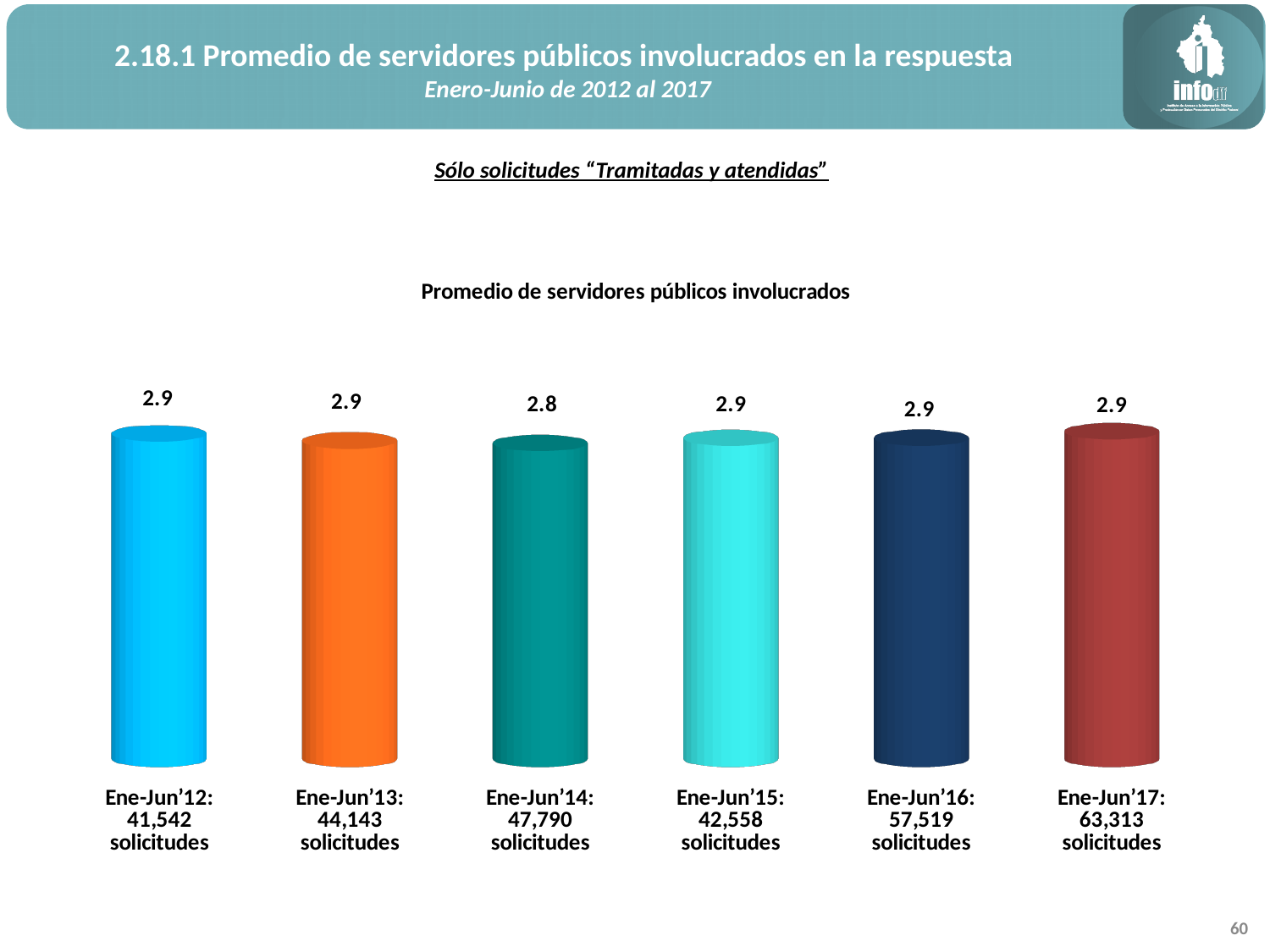
How many periods (bars) are shown in the chart? 6 What is the value for Ene-Jun'17 in the chart? 2.9 What is the value for Ene-Jun'12 in the chart? 2.9 What is the difference between the values for Ene-Jun'13 and Ene-Jun'14? 0.1 What kind of chart is shown on the slide? Bar chart What is the value for Ene-Jun'16 in the chart? 2.9 Which period has the lowest average number of public servants involved? Ene-Jun'14 Which is larger, the value for Ene-Jun'15 or the value for Ene-Jun'14? Ene-Jun'15 How many solicitudes are listed under the Ene-Jun'17 label? 63,313 solicitudes What is the value for Ene-Jun'14 in the chart? 2.8 What is the title of the chart? Promedio de servidores públicos involucrados